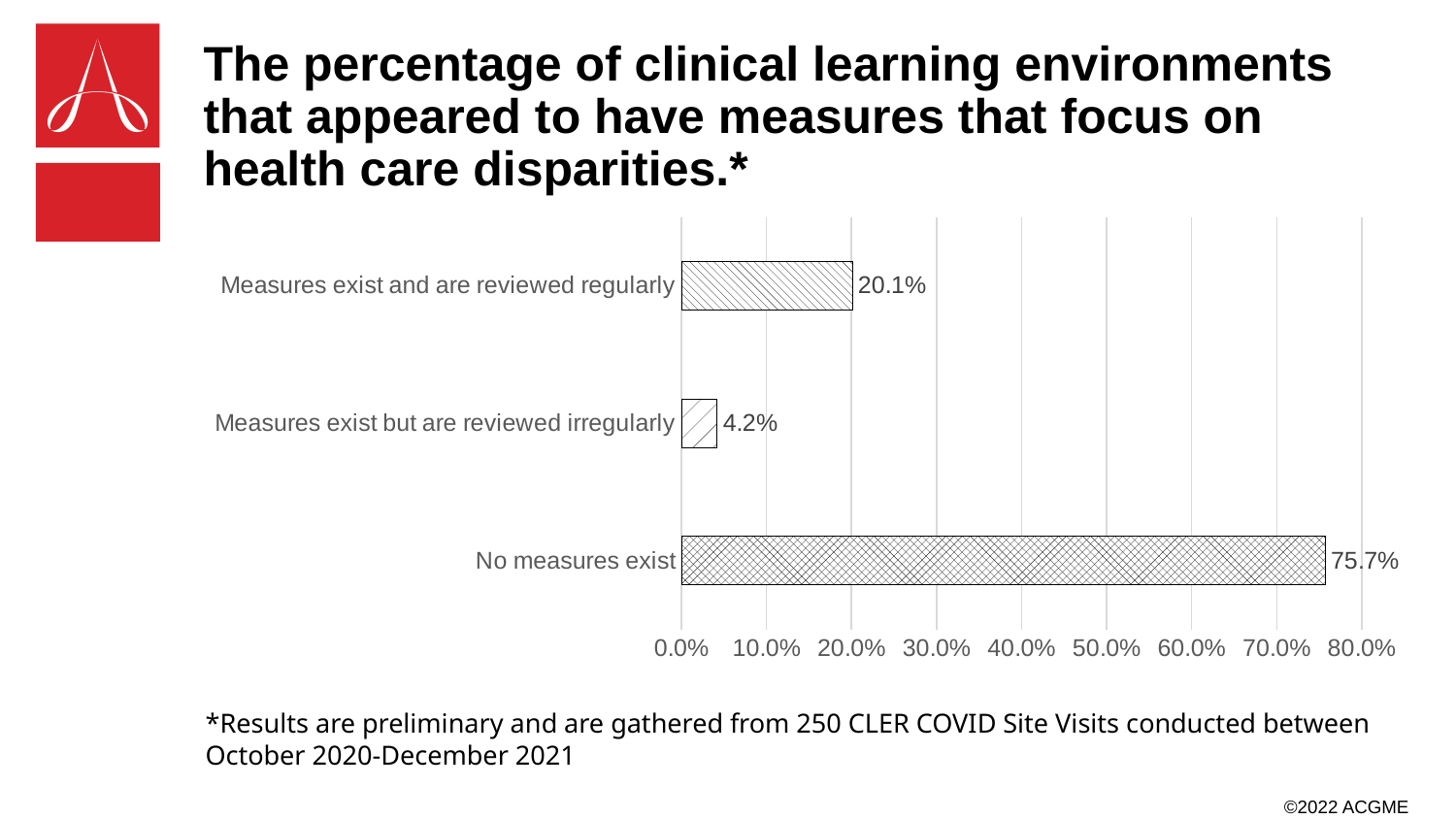
How many categories are shown in the chart? 3 What percentage of clinical learning environments had no measures exist? 75.7% Which is larger: the percentage for 'Measures exist and are reviewed regularly' or for 'Measures exist but are reviewed irregularly'? Measures exist and are reviewed regularly Is the value for 'No measures exist' greater or less than 70.0%? greater Which category has the lowest percentage? Measures exist but are reviewed irregularly What is the difference in percentage points between 'Measures exist and are reviewed regularly' and 'Measures exist but are reviewed irregularly'? 15.9 What percentage of clinical learning environments had measures that exist but are reviewed irregularly? 4.2% What is the maximum value shown on the x axis? 80.0% What kind of chart is shown on the slide? Bar chart Which category has the highest percentage? No measures exist What percentage of clinical learning environments had measures that exist and are reviewed regularly? 20.1% What is the difference in percentage points between 'No measures exist' and 'Measures exist and are reviewed regularly'? 55.6